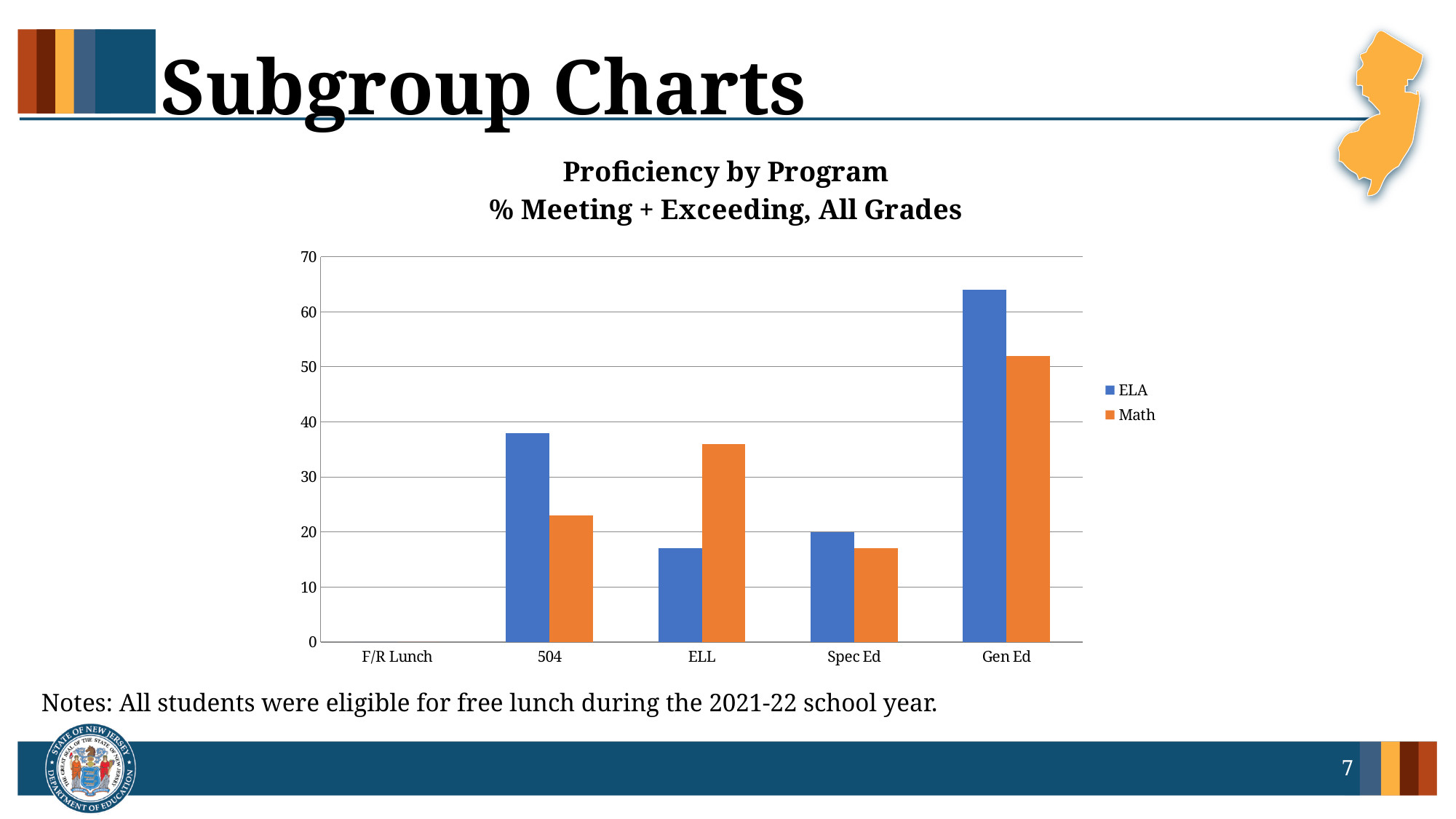
How many series does the legend list? 2 Is the ELA value for Gen Ed greater or less than 60? greater What kind of chart is shown on the slide? Bar chart Is the ELA value for 504 greater or less than 40? less How many program categories are shown on the x axis? 5 For the 504 program, which is larger, the ELA value or the Math value? ELA Among the programs with bars, which has the lowest Math value? Spec Ed For the ELL program, which is larger, the ELA value or the Math value? Math Which program has the highest Math value? Gen Ed Which program has the highest ELA value? Gen Ed What is the title of the chart? Proficiency by Program % Meeting + Exceeding, All Grades Is the Math value for Gen Ed greater or less than 50? greater